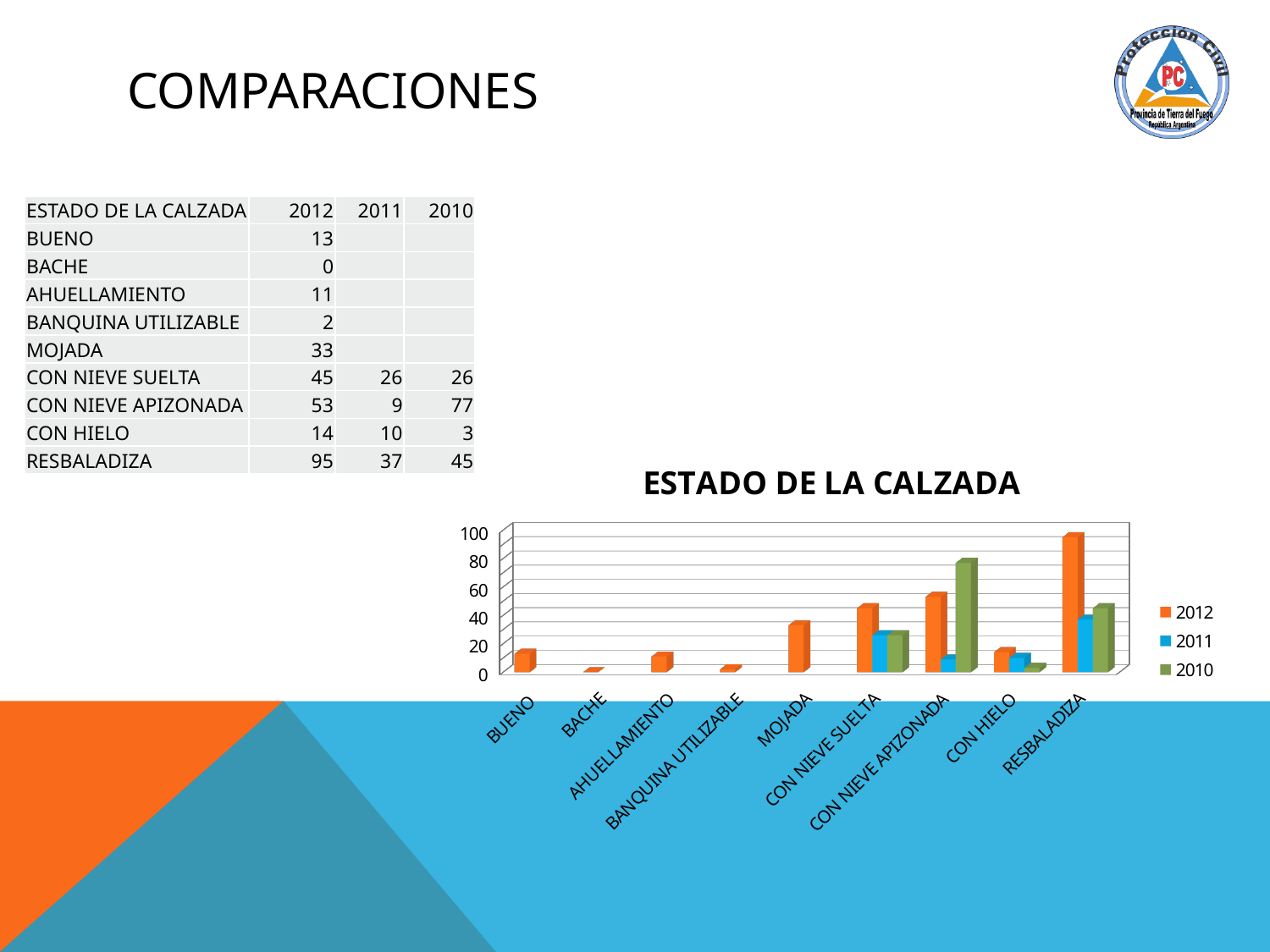
How many series does the legend of the ESTADO DE LA CALZADA chart list? 3 What is the 2011 value for CON HIELO? 10 What kind of chart is shown under the title ESTADO DE LA CALZADA? bar chart Is the 2012 value for CON NIEVE APIZONADA greater or less than 40? greater Which colour represents the 2011 series in the ESTADO DE LA CALZADA chart? blue What is the 2010 value for CON NIEVE APIZONADA? 77 For CON NIEVE APIZONADA, which year has the larger value, 2012 or 2010? 2010 What is the difference between the 2012 and 2011 values for RESBALADIZA? 58 Which category has the lowest 2012 value? BACHE How many categories are shown on the x axis of the ESTADO DE LA CALZADA chart? 9 What is the 2012 value for RESBALADIZA? 95 Which category has the highest 2012 value? RESBALADIZA